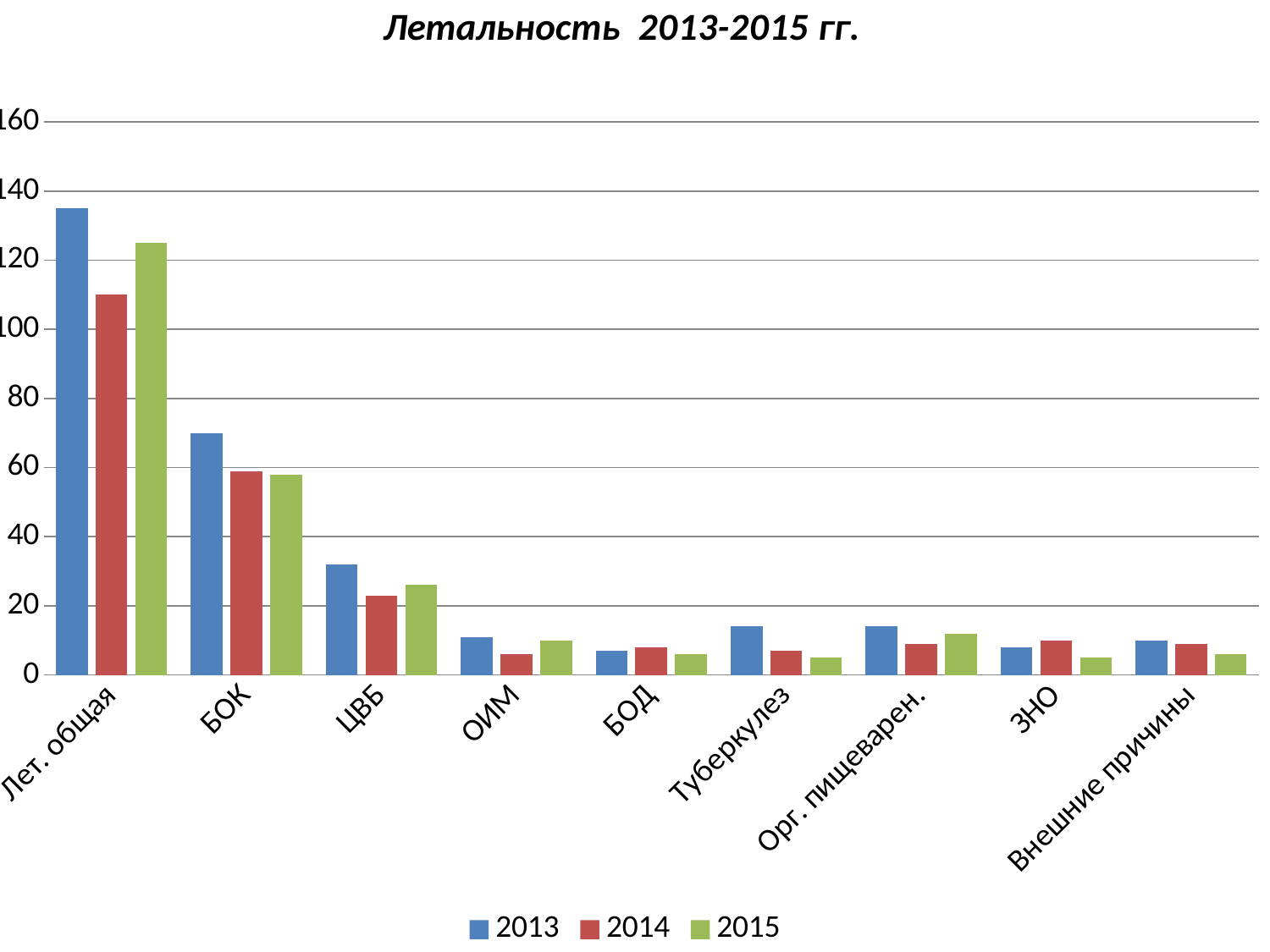
How many categories are shown on the x axis? 9 Is the value for Лет. общая in 2014 greater or less than 120? less Is the value for ЦВБ in 2014 greater or less than 40? less For ЦВБ, which year has the larger value, 2013 or 2014? 2013 Which series is shown in green in the legend? 2015 Is the value for БОК in 2013 greater or less than 60? greater How many series does the legend list? 3 Which category has the highest value for 2013? Лет. общая What kind of chart is shown on the slide? bar chart For Лет. общая, which year has the larger value, 2014 or 2015? 2015 What is the title of the chart? Летальность 2013-2015 гг.